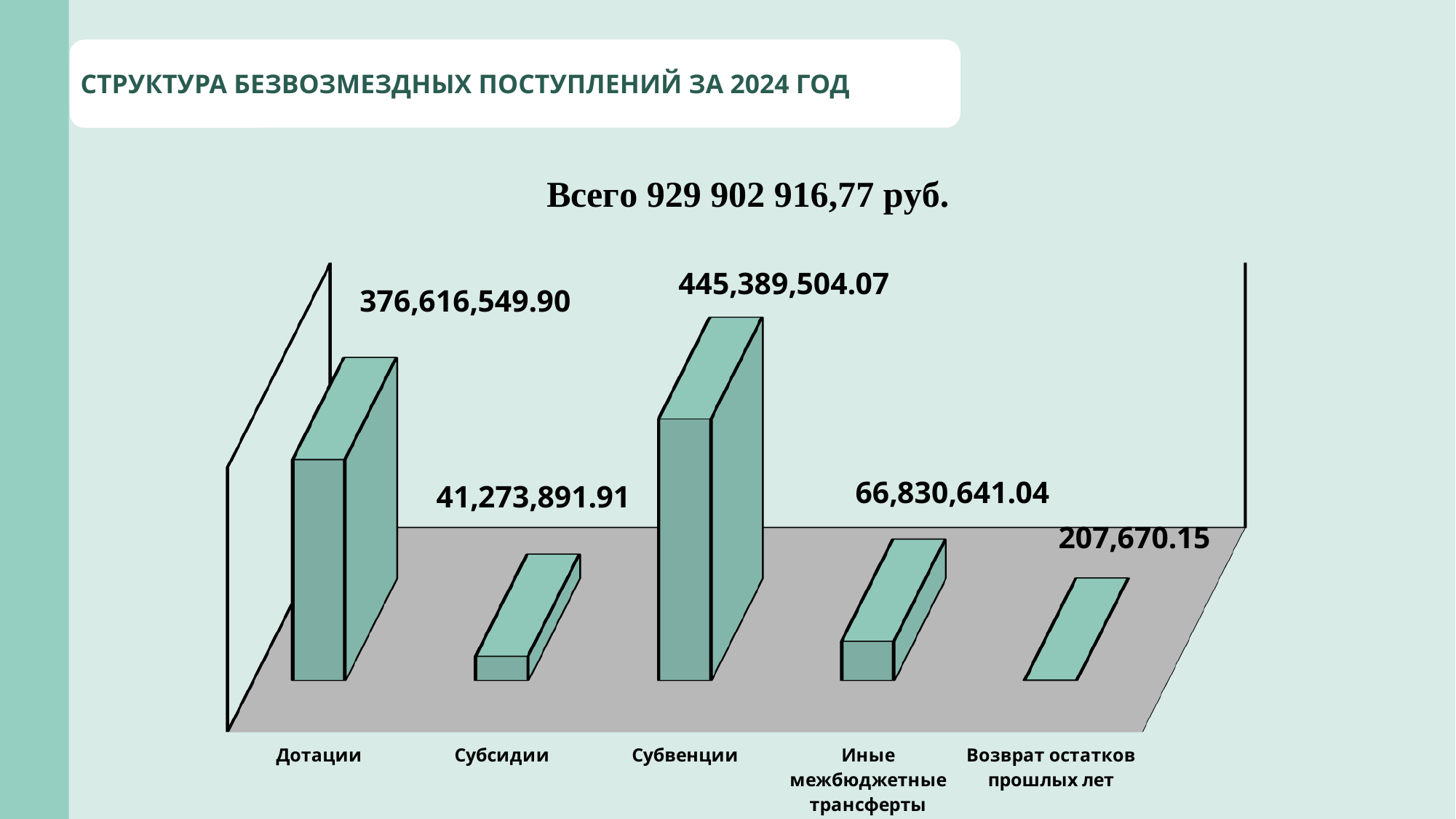
What is the value for Субсидии? 41,273,891.91 Which category has the highest value? Субвенции How many categories are shown in the chart? 5 What is the value for Дотации? 376,616,549.90 What is the value for Возврат остатков прошлых лет? 207,670.15 What is the difference between the values for Субвенции and Дотации? 68,772,954.17 What is the value for Иные межбюджетные трансферты? 66,830,641.04 What kind of chart is shown on the slide? Bar chart Which is larger, the value for Субсидии or the value for Иные межбюджетные трансферты? Иные межбюджетные трансферты What is the difference between the values for Иные межбюджетные трансферты and Субсидии? 25,556,749.13 Which category has the lowest value? Возврат остатков прошлых лет What is the value for Субвенции? 445,389,504.07